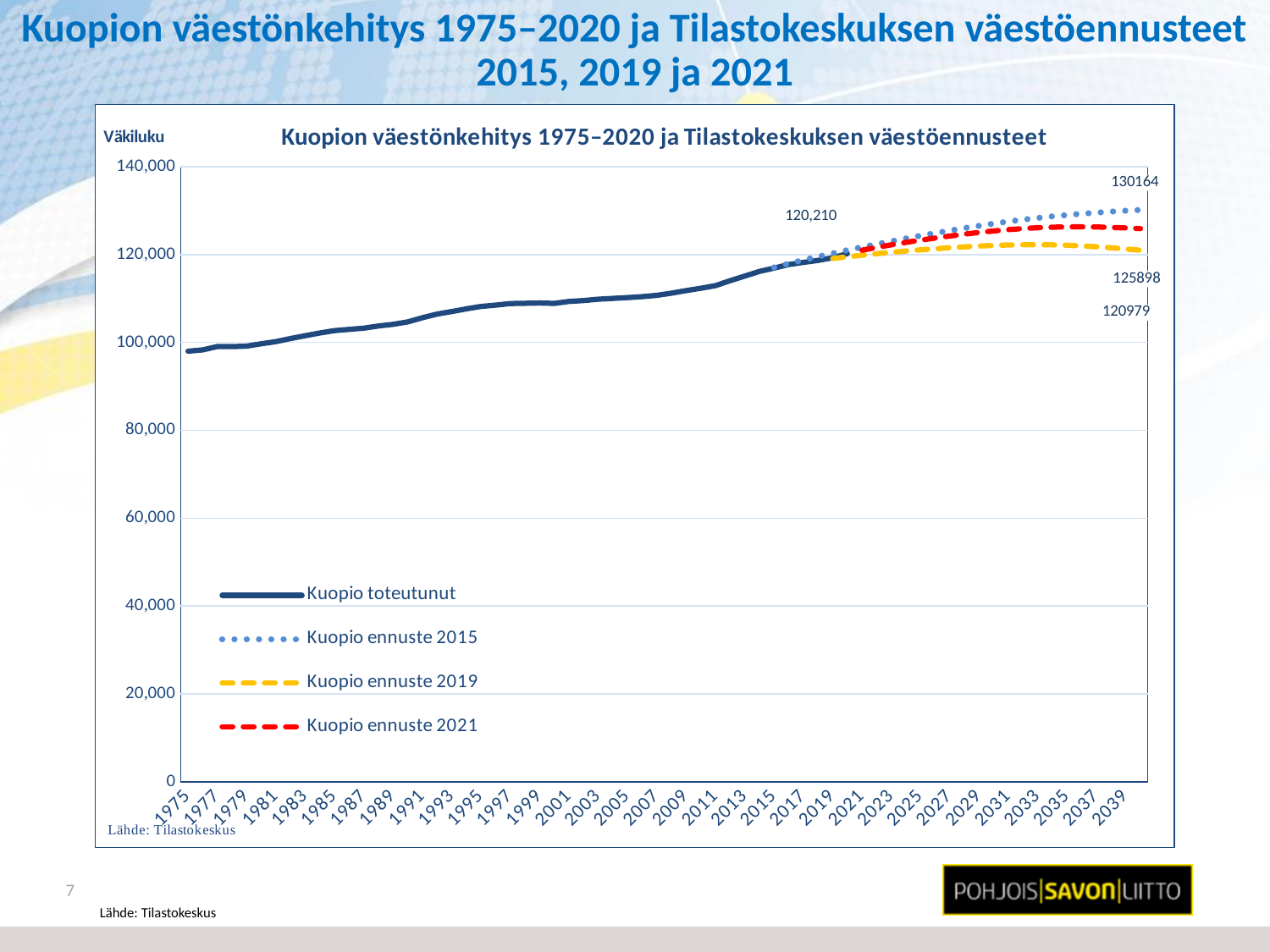
Does the Kuopio toteutunut line rise or fall from 1975 to 2020? rise What is the final labelled value of the Kuopio ennuste 2021 series? 125898 What is the final labelled value of the Kuopio ennuste 2019 series? 120979 What kind of chart is shown on the slide? line chart What is the final labelled value of the Kuopio ennuste 2015 series? 130164 Which ends higher, Kuopio ennuste 2021 or Kuopio ennuste 2019? Kuopio ennuste 2021 What is the difference between the final values of Kuopio ennuste 2015 (130164) and Kuopio ennuste 2019 (120979)? 9185 Which forecast series ends at the highest value? Kuopio ennuste 2015 What value is labelled at the end of the Kuopio toteutunut line? 120,210 How many series does the legend list? 4 Which forecast series ends at the lowest value? Kuopio ennuste 2019 Is the Kuopio toteutunut value in 1975 greater or less than 100,000? less